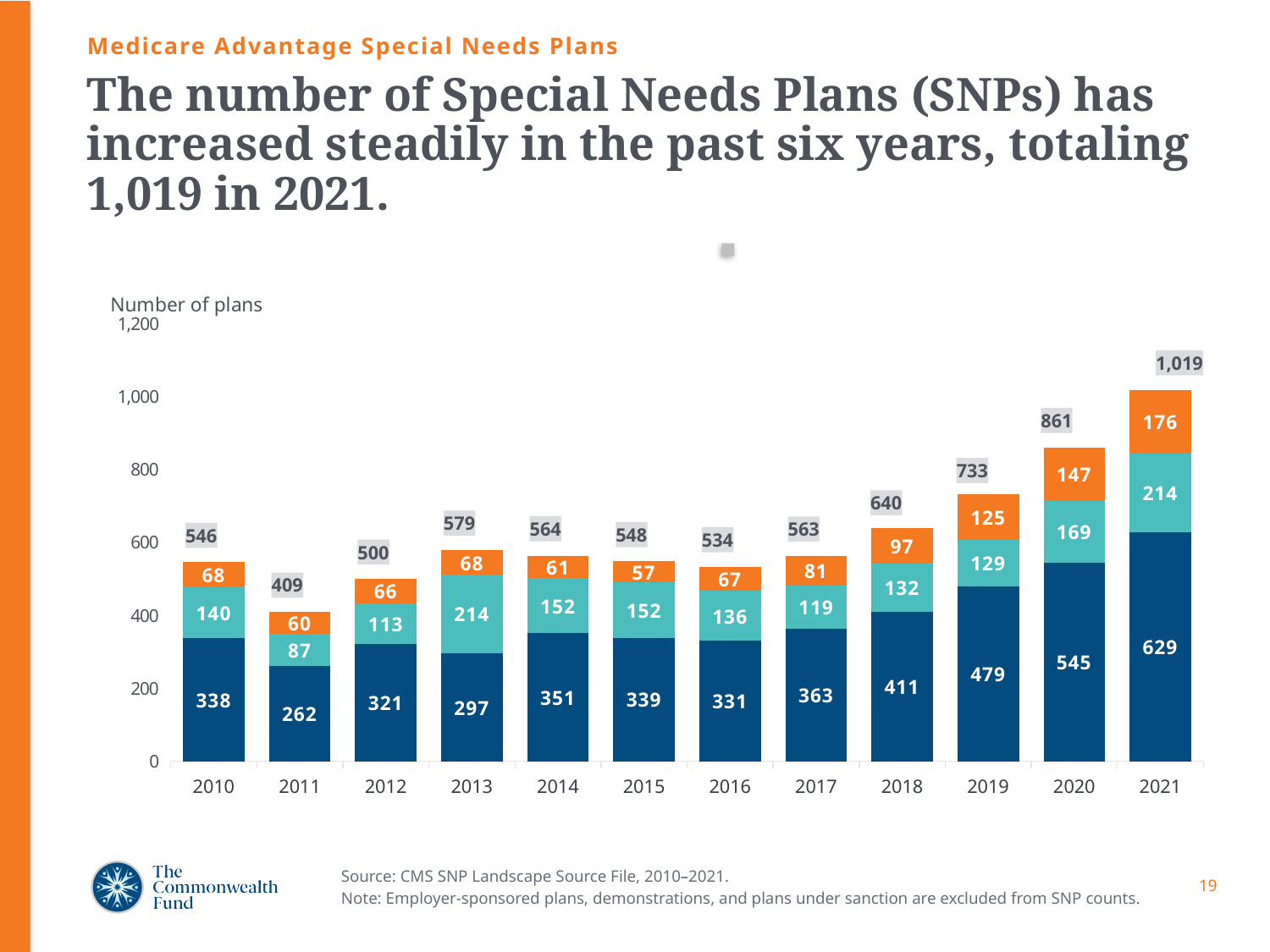
Which year has a larger total, 2014 or 2015? 2014 What is the difference between the total for 2021 and the total for 2020? 158 What is the label on the vertical axis of the chart? Number of plans What is the total number of plans for 2018? 640 What is the value of the bottom (dark blue) segment of the 2021 bar? 629 What kind of chart is shown on the slide? Stacked bar chart How many years are shown on the x axis? 12 What is the total number of plans shown for 2021? 1,019 Is the total for 2019 greater or less than 800? less Do the total values rise or fall from 2016 to 2021? Rise Which year has the lowest total number of plans? 2011 Which year has the highest total number of plans? 2021